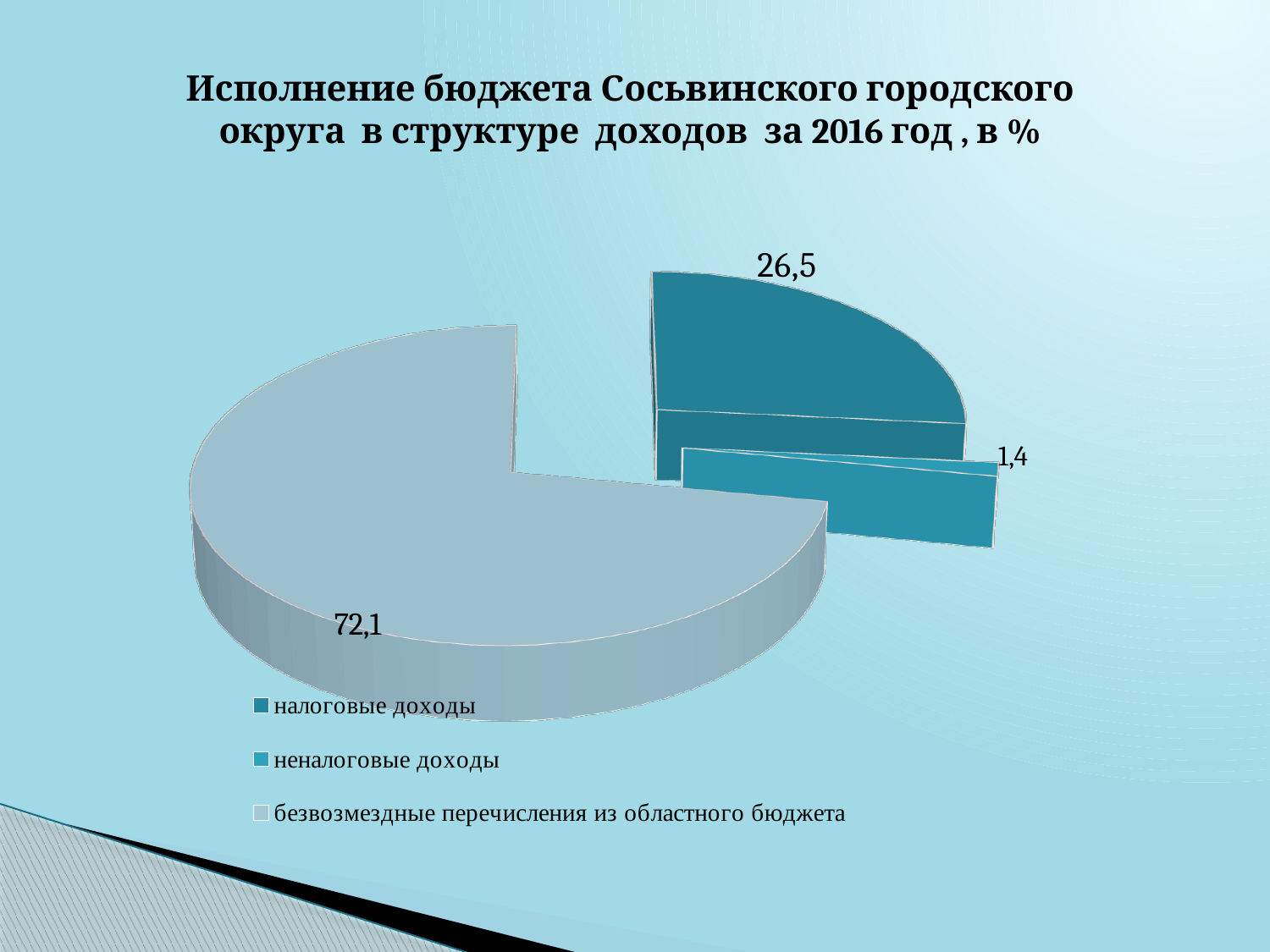
How many categories does the pie chart have? 3 What type of chart is shown on the slide? Pie chart What is the difference between the values for безвозмездные перечисления из областного бюджета and налоговые доходы? 45,6 How many entries does the legend list? 3 Which category has the smallest share of the pie? неналоговые доходы What is the difference between the values for налоговые доходы and неналоговые доходы? 25,1 Which is larger: налоговые доходы or неналоговые доходы? налоговые доходы What is the value for неналоговые доходы? 1,4 Which category has the largest share of the pie? безвозмездные перечисления из областного бюджета What is the title of the chart? Исполнение бюджета Сосьвинского городского округа в структуре доходов за 2016 год , в % What is the value for безвозмездные перечисления из областного бюджета? 72,1 What is the value for налоговые доходы? 26,5